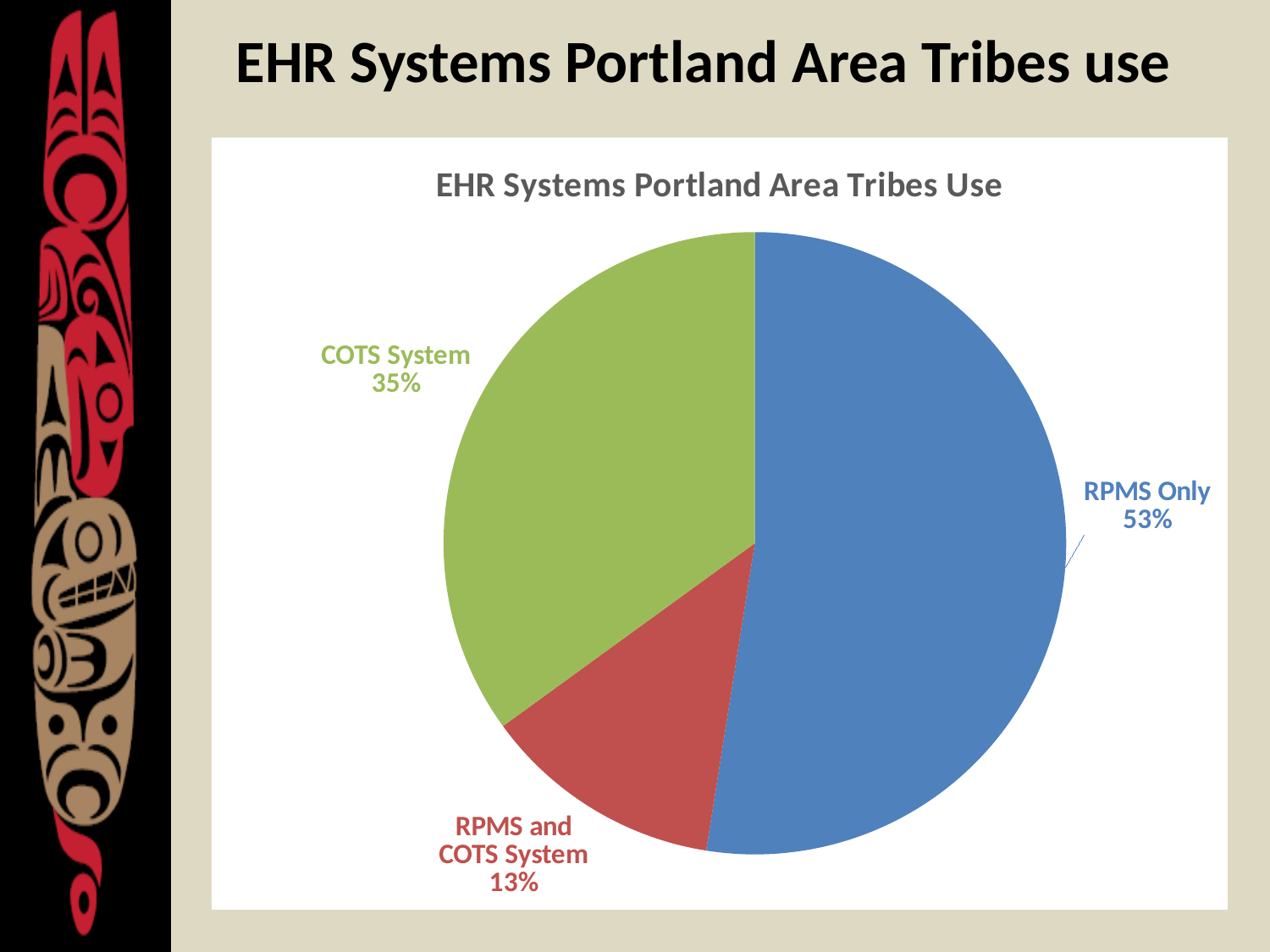
What colour is the RPMS Only slice? blue What kind of chart is shown on the slide? pie chart What is the chart's title? EHR Systems Portland Area Tribes Use What is the difference in percentage points between RPMS Only and COTS System? 18 What is the difference in percentage points between COTS System and RPMS and COTS System? 22 What percentage of Portland Area Tribes use RPMS and COTS System? 13% What percentage of Portland Area Tribes use RPMS Only? 53% How many slices does the pie chart have? 3 Which category has the smallest share of the pie? RPMS and COTS System What percentage of Portland Area Tribes use a COTS System? 35% Which category has the largest share of the pie? RPMS Only Which is larger, the share for COTS System or the share for RPMS and COTS System? COTS System